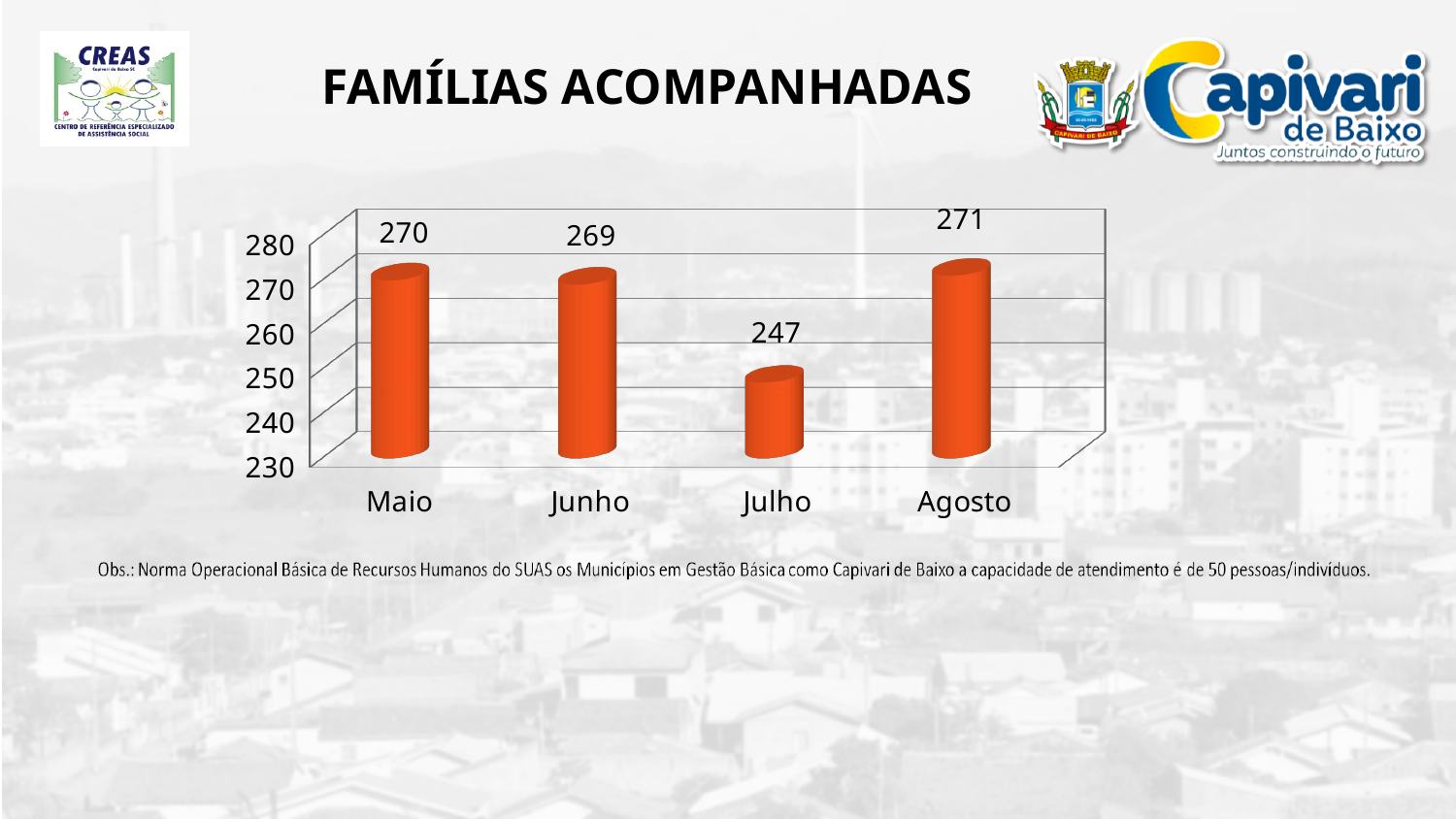
What is the value for Agosto? 271 What kind of chart is shown on the slide? bar chart Which month has the lowest value? Julho What is the difference between the values for Agosto and Julho? 24 What is the title of the slide above the chart? FAMÍLIAS ACOMPANHADAS Is the value for Julho greater or less than 260? less What is the value for Junho? 269 How many months are shown on the chart? 4 What is the difference between the values for Maio and Junho? 1 Which is larger, the value for Maio or the value for Julho? Maio What is the value for Julho? 247 What is the value for Maio? 270